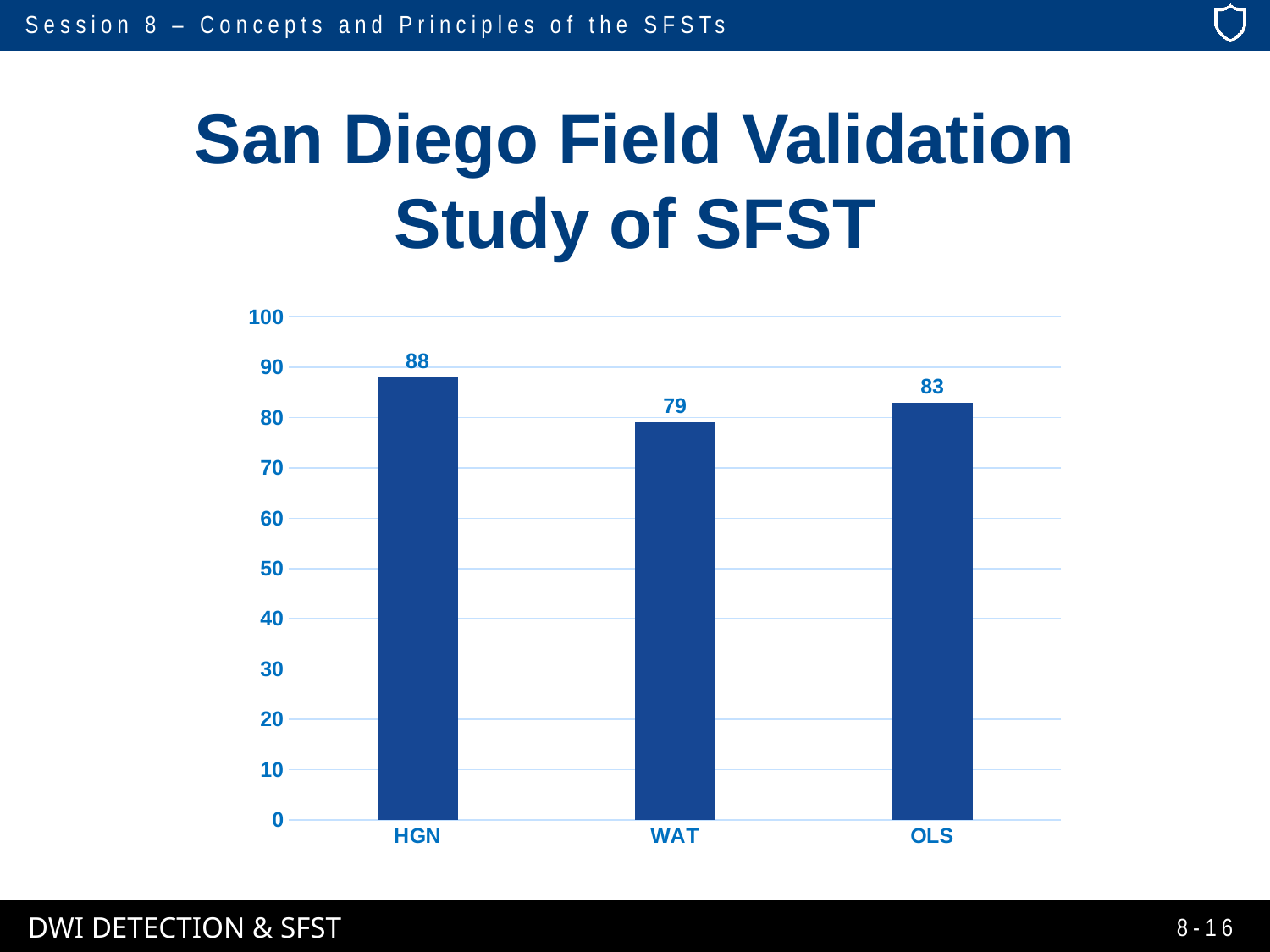
What is the difference between the values for HGN and WAT? 9 Which is larger, the value for HGN or the value for OLS? HGN What is the difference between the values for OLS and WAT? 4 Is the value for WAT greater or less than 80? less How many categories are shown on the x axis? 3 Which category has the lowest value? WAT What kind of chart is shown on the slide? bar chart What is the value for OLS? 83 Which category has the highest value? HGN What is the value for WAT? 79 What is the value for HGN? 88 What is the title of the slide containing the chart? San Diego Field Validation Study of SFST